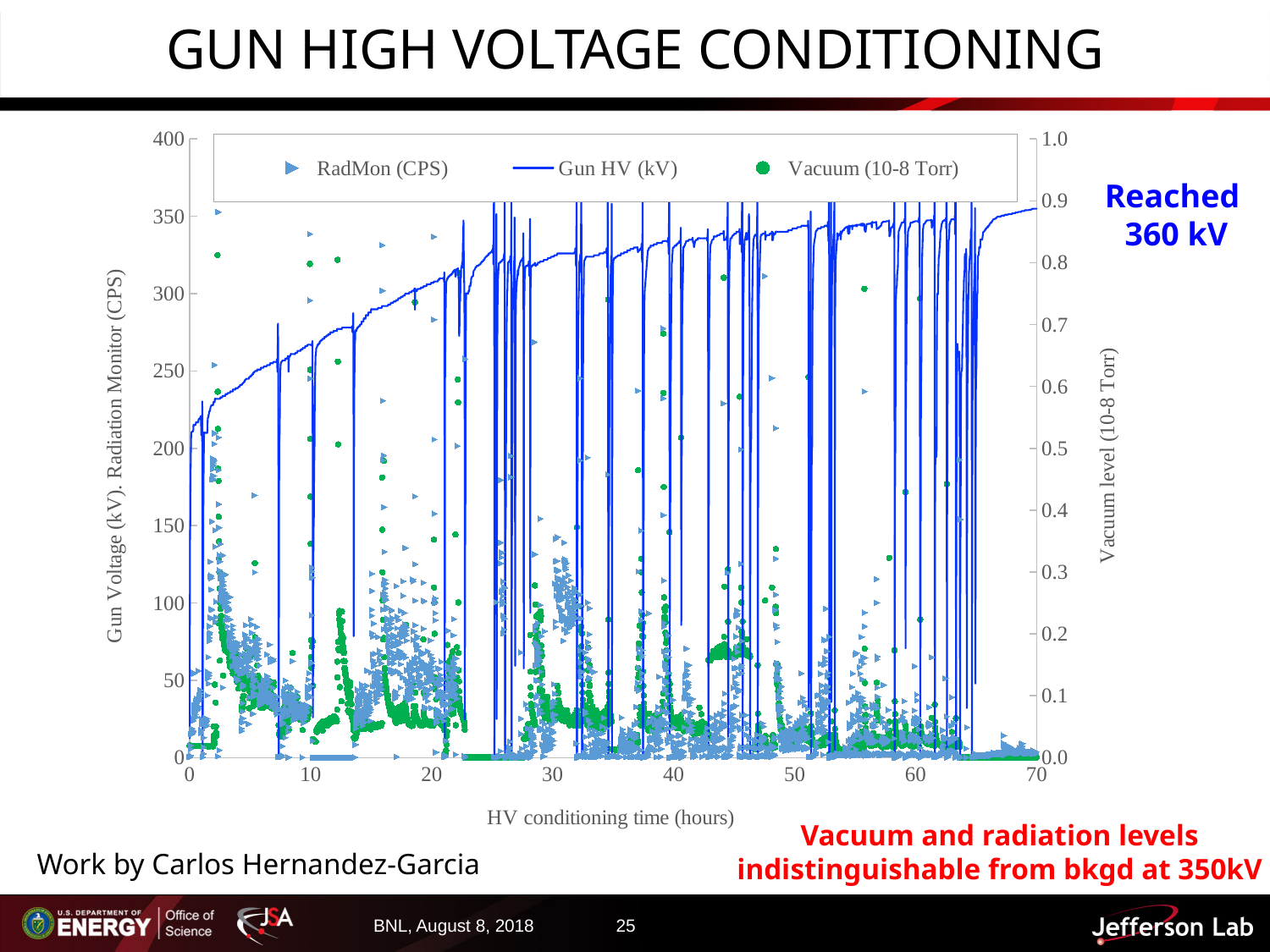
What is the maximum value shown on the left y-axis of the chart? 400 Is the Gun HV (kV) value at 0 hours greater or less than 250? less What are the three series named in the chart legend? RadMon (CPS), Gun HV (kV), Vacuum (10-8 Torr) Is the Gun HV (kV) value at 40 hours greater or less than 300? greater What is the x-axis title of the chart? HV conditioning time (hours) Does the Gun HV (kV) line generally rise or fall as HV conditioning time increases? rise Is the Gun HV (kV) value at 10 hours greater or less than 300? less What is the maximum value shown on the right y-axis (Vacuum level) of the chart? 1.0 What is the maximum HV conditioning time shown on the x-axis? 70 How many series does the chart legend list? 3 Which series is plotted as a continuous line rather than as markers? Gun HV (kV)